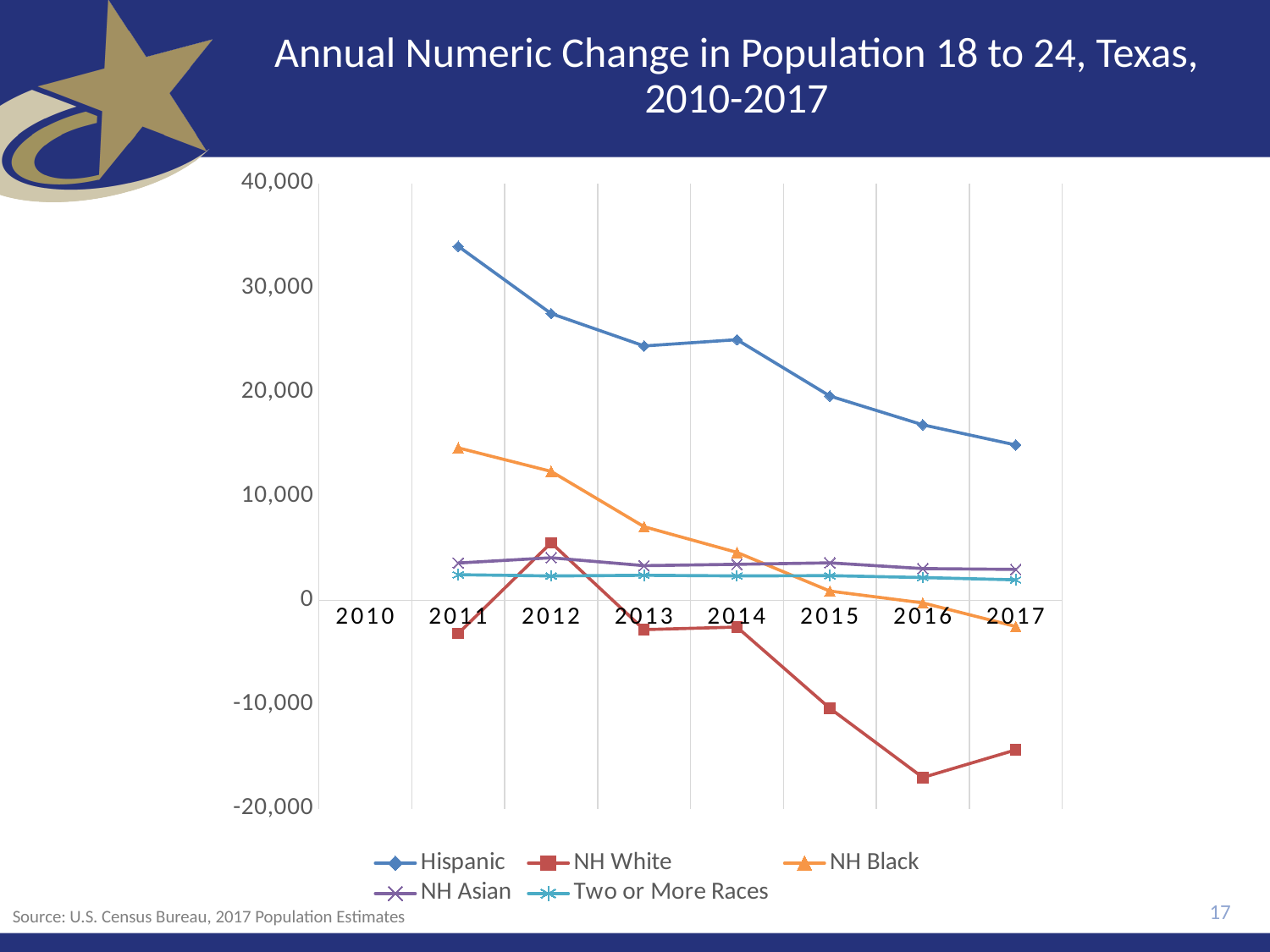
Which series are listed in the legend? Hispanic, NH White, NH Black, NH Asian, Two or More Races Is the value for Hispanic in 2011 greater or less than 30,000? greater In 2015, which is larger: the value for NH Black or the value for NH Asian? NH Asian Is the value for Hispanic in 2017 greater or less than 20,000? less Does the Hispanic series rise or fall from 2011 to 2017? fall Which series has the highest value in 2011? Hispanic What is the title of the chart? Annual Numeric Change in Population 18 to 24, Texas, 2010-2017 What kind of chart is shown on the slide? line chart How many series does the legend list? 5 In which year does the NH White series reach its highest value? 2012 Which series has the lowest value in 2016? NH White Is the value for NH White in 2016 greater or less than -10,000? less